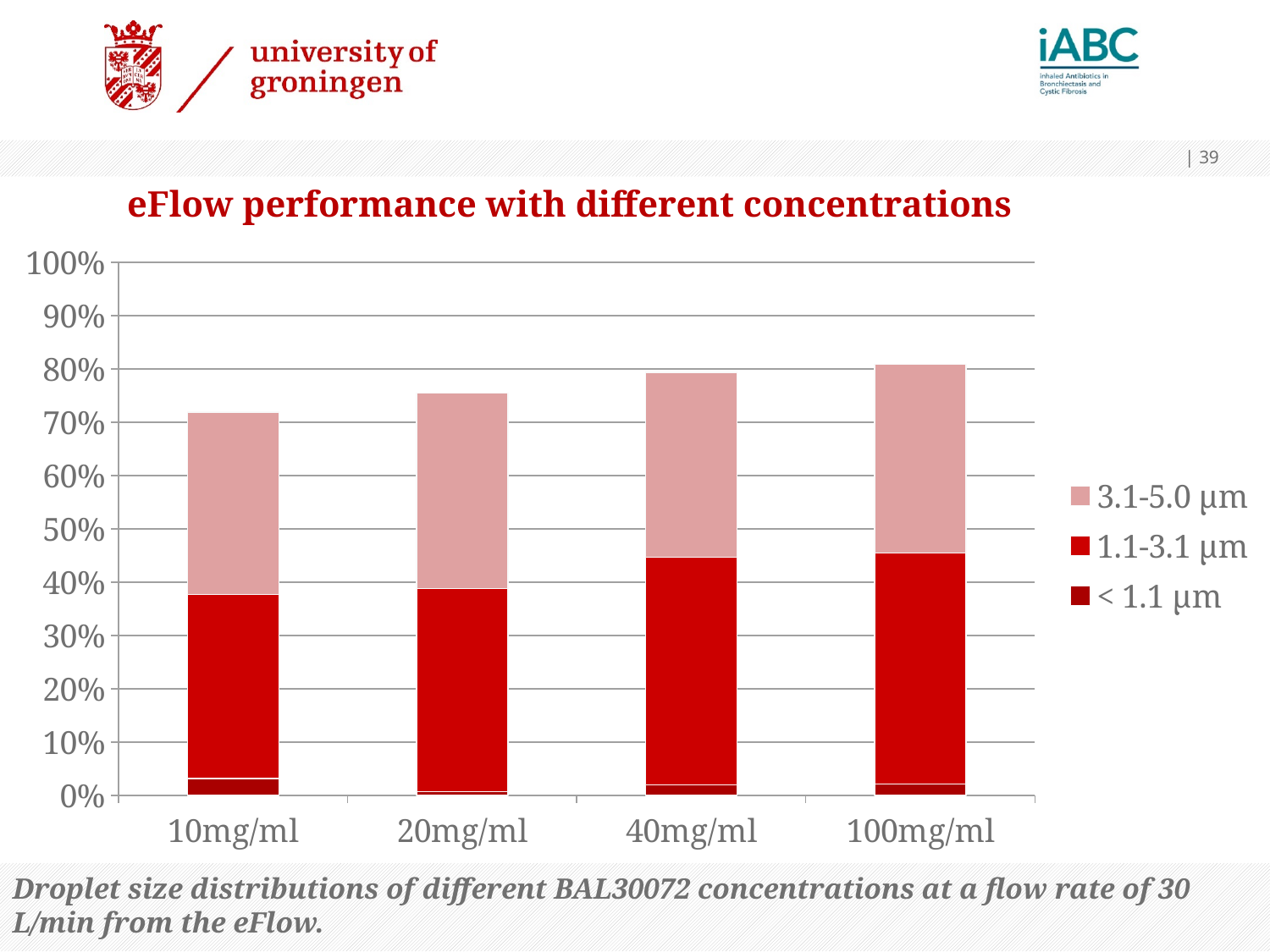
Is the total stacked bar for 20mg/ml greater or less than 80%? less Which concentration has the lowest total stacked bar height? 10mg/ml How many series does the legend list? 3 Is the total stacked bar for 40mg/ml greater or less than 70%? greater How many concentration categories are shown on the x axis? 4 Do the total stacked bar heights rise or fall as concentration increases from 10mg/ml to 100mg/ml? rise Which has a larger total stacked bar, 10mg/ml or 100mg/ml? 100mg/ml What kind of chart is shown on the slide? Stacked bar chart Is the total stacked bar for 10mg/ml greater or less than 80%? less What is the title of the chart? eFlow performance with different concentrations Which concentration has the highest total stacked bar height? 100mg/ml Which series is shown at the bottom of each stacked bar? < 1.1 µm